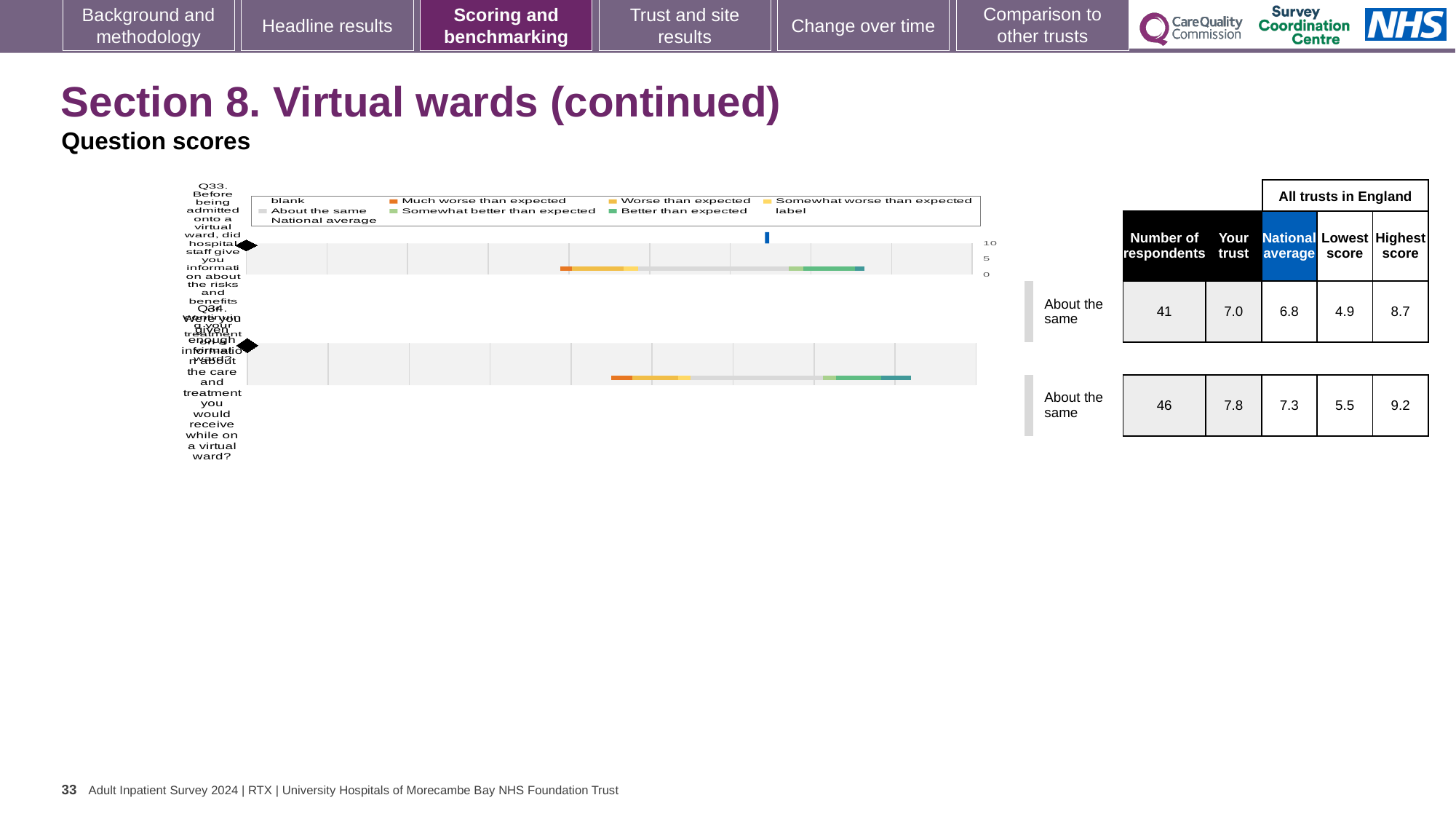
What is the highest score among all trusts in England for Q34? 9.2 What is the difference between the highest and lowest scores for Q34? 3.7 What kind of chart is used to show the question scores on this slide? bar chart What is the 'Your trust' score for Q33? 7.0 What is the national average score for Q34? 7.3 Which question has the higher 'Your trust' score, Q33 or Q34? Q34 What is the lowest score among all trusts in England for Q33? 4.9 By how much does the trust's score for Q33 exceed the national average? 0.2 What colour does the legend use for 'Much worse than expected'? orange What benchmark category is shown for Q34? About the same How many respondents answered Q33? 41 How many questions (rows) are plotted in the chart? 2